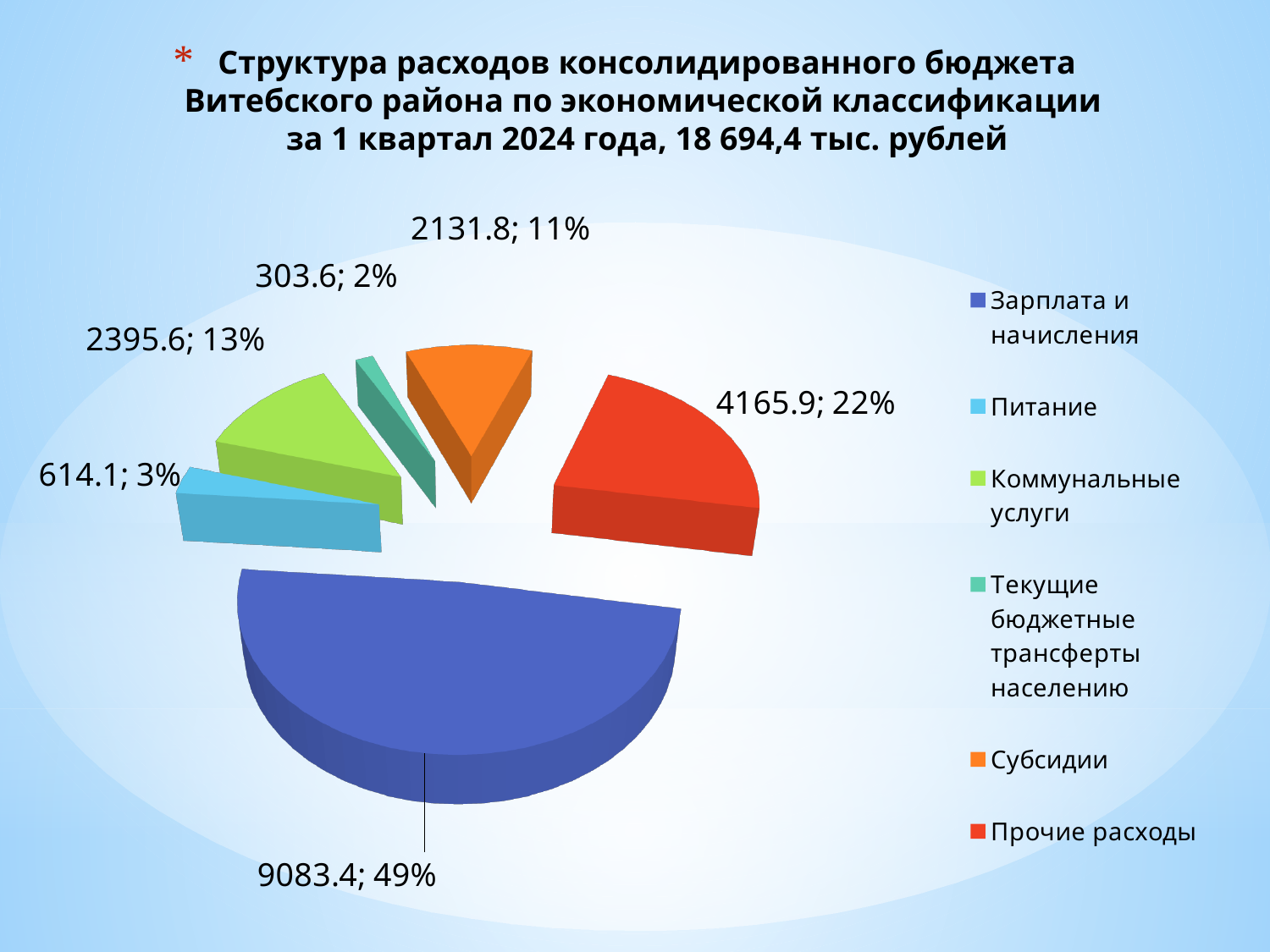
What share of the pie does Коммунальные услуги take? 13% What share of the pie does Зарплата и начисления take? 49% Which category has the largest slice of the pie? Зарплата и начисления What value is shown for Прочие расходы? 4165.9 Which is larger, the value for Коммунальные услуги or the value for Субсидии? Коммунальные услуги Which category has the smallest slice of the pie? Текущие бюджетные трансферты населению What value is shown for Питание? 614.1 What kind of chart is shown on the slide? Pie chart How many categories does the legend of the pie chart list? 6 What value is shown for Зарплата и начисления? 9083.4 What colour is the slice for Субсидии? Orange What is the difference between the values for Прочие расходы and Субсидии? 2034.1